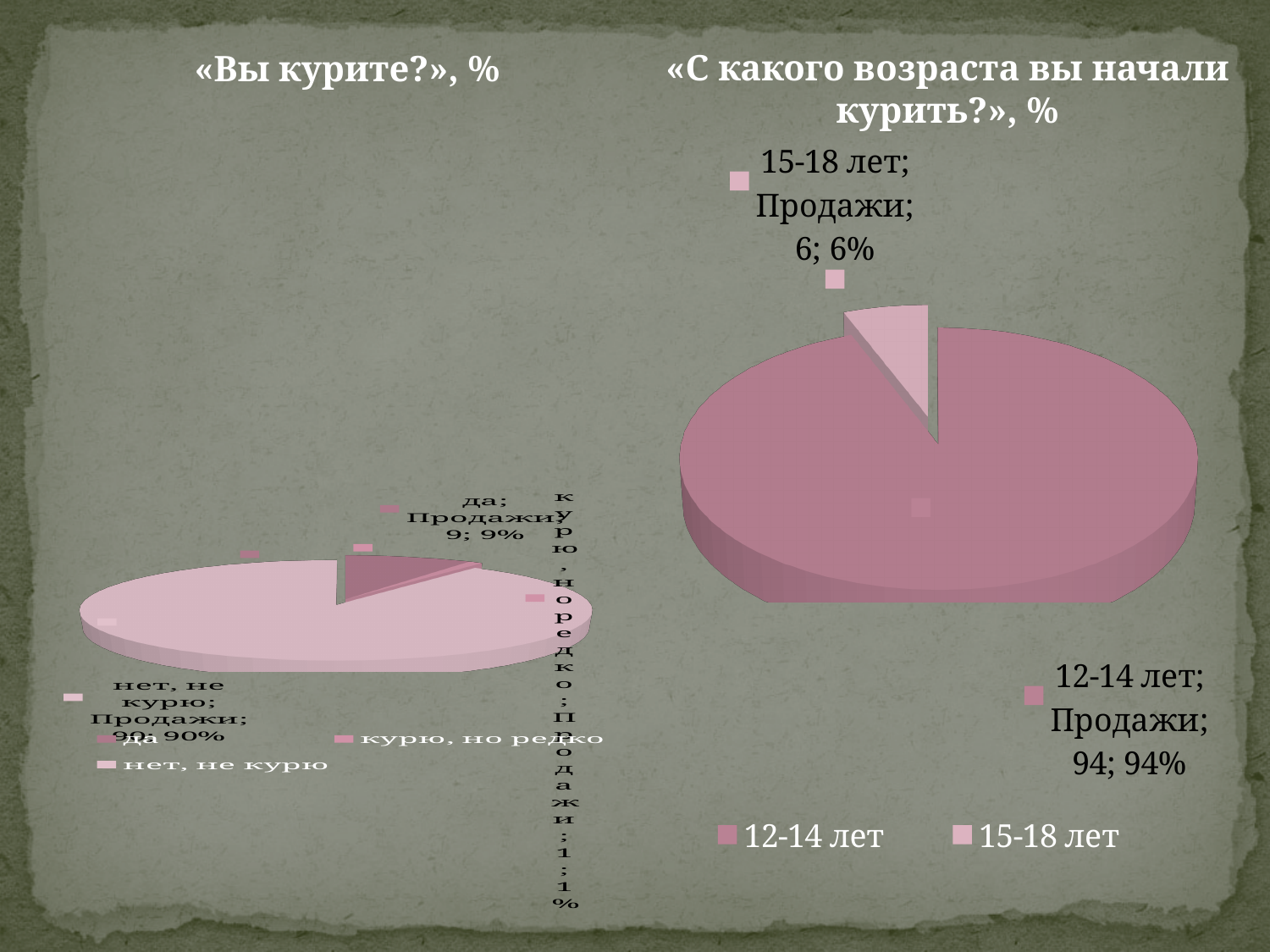
What type of chart is the one titled «С какого возраста вы начали курить?», %? pie chart In the chart titled «С какого возраста вы начали курить?», %, what percentage is shown for «12-14 лет»? 94% In the chart titled «Вы курите?», %, what is the difference in percentage points between «нет, не курю» and «да»? 81 In the chart titled «С какого возраста вы начали курить?», %, what percentage is shown for «15-18 лет»? 6% In the chart titled «С какого возраста вы начали курить?», %, what is the difference in percentage points between «12-14 лет» and «15-18 лет»? 88 In the chart titled «С какого возраста вы начали курить?», %, which category has the larger slice, «12-14 лет» or «15-18 лет»? 12-14 лет In the chart titled «Вы курите?», %, what percentage is shown for «курю, но редко»? 1% In the chart titled «Вы курите?», %, how many categories does the legend list? 3 In the chart titled «Вы курите?», %, what percentage is shown for «нет, не курю»? 90% In the chart titled «Вы курите?», %, which category has the largest slice? нет, не курю In the chart titled «Вы курите?», %, which category has the smallest slice? курю, но редко In the chart titled «Вы курите?», %, what percentage is shown for «да»? 9%